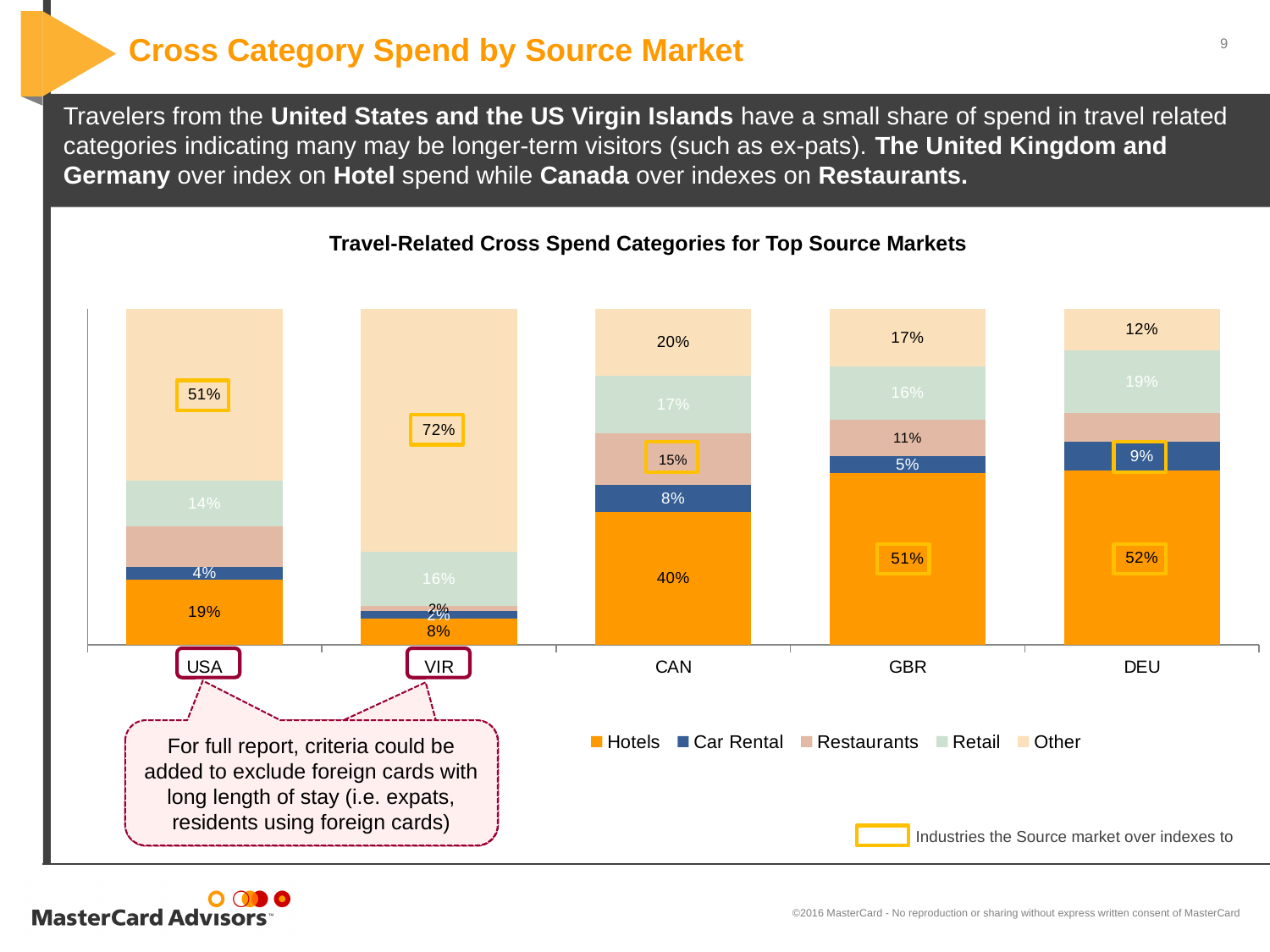
Which is larger: the Restaurants share for CAN or the Restaurants share for GBR? CAN What is the Hotels share for CAN? 40% What is the Other share for VIR? 72% What is the Car Rental share for DEU? 9% Which source market has the lowest Hotels share? VIR What is the difference between the Other share for VIR and the Other share for USA? 21% Which source market has the highest Hotels share? DEU How many source markets are shown on the x axis? 5 How many series does the legend list? 5 What is the title of the chart? Travel-Related Cross Spend Categories for Top Source Markets What kind of chart is shown? Stacked bar chart What is the Retail share for GBR? 16%